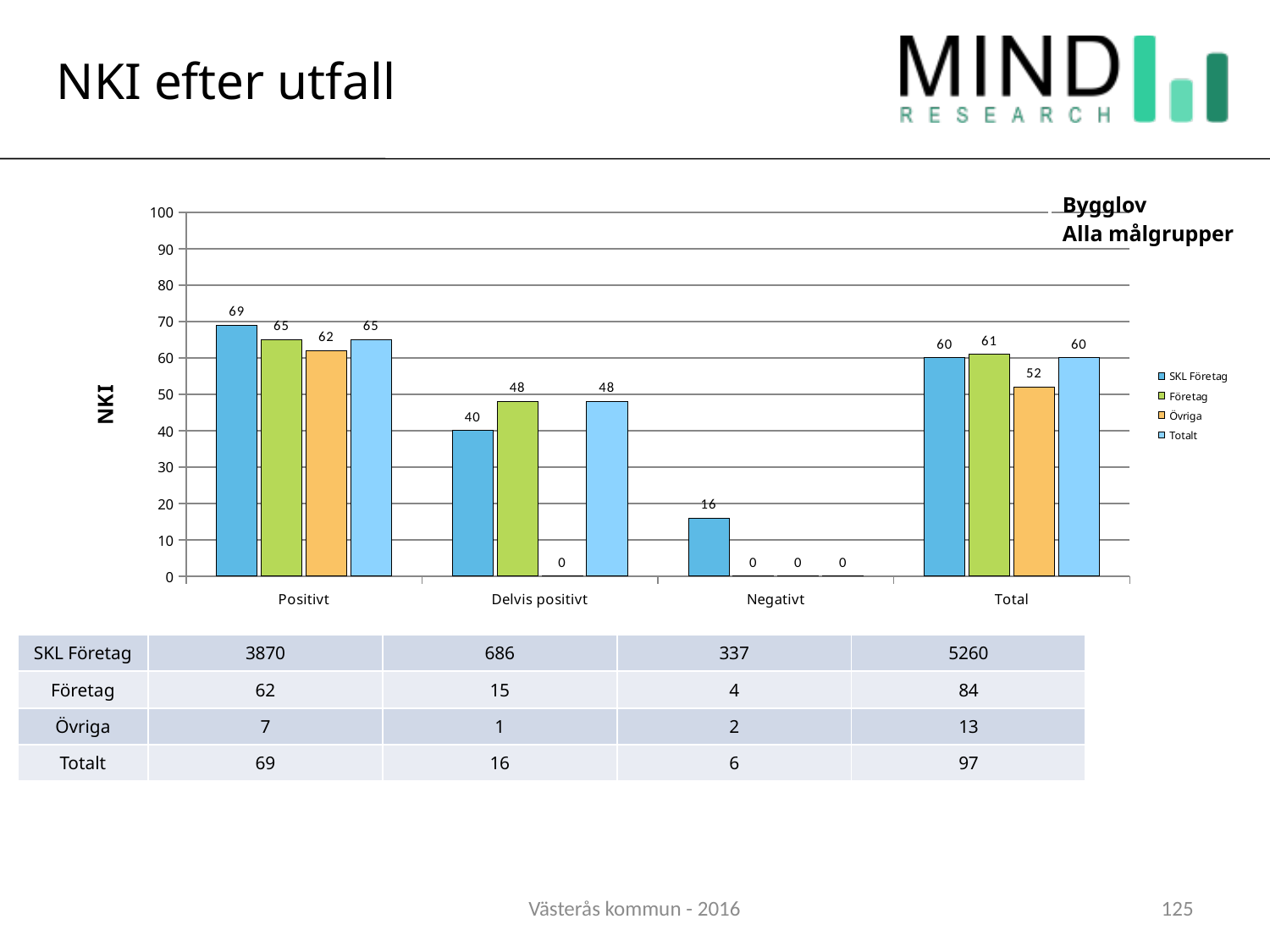
What is the difference between the SKL Företag value and the Övriga value in the Positivt category? 7 How many series does the chart legend list? 4 What is the NKI value for SKL Företag in the Positivt category? 69 How many categories are shown on the x axis of the chart? 4 What is the NKI value for Övriga in the Total category? 52 Which is larger: the SKL Företag value or the Företag value in the Delvis positivt category? Företag What is the NKI value for Företag in the Delvis positivt category? 48 Which series has the lowest NKI value in the Total category? Övriga Which series has the highest NKI value in the Positivt category? SKL Företag What is the label on the vertical axis of the chart? NKI What is the NKI value for SKL Företag in the Negativt category? 16 What kind of chart is shown on the slide? Bar chart